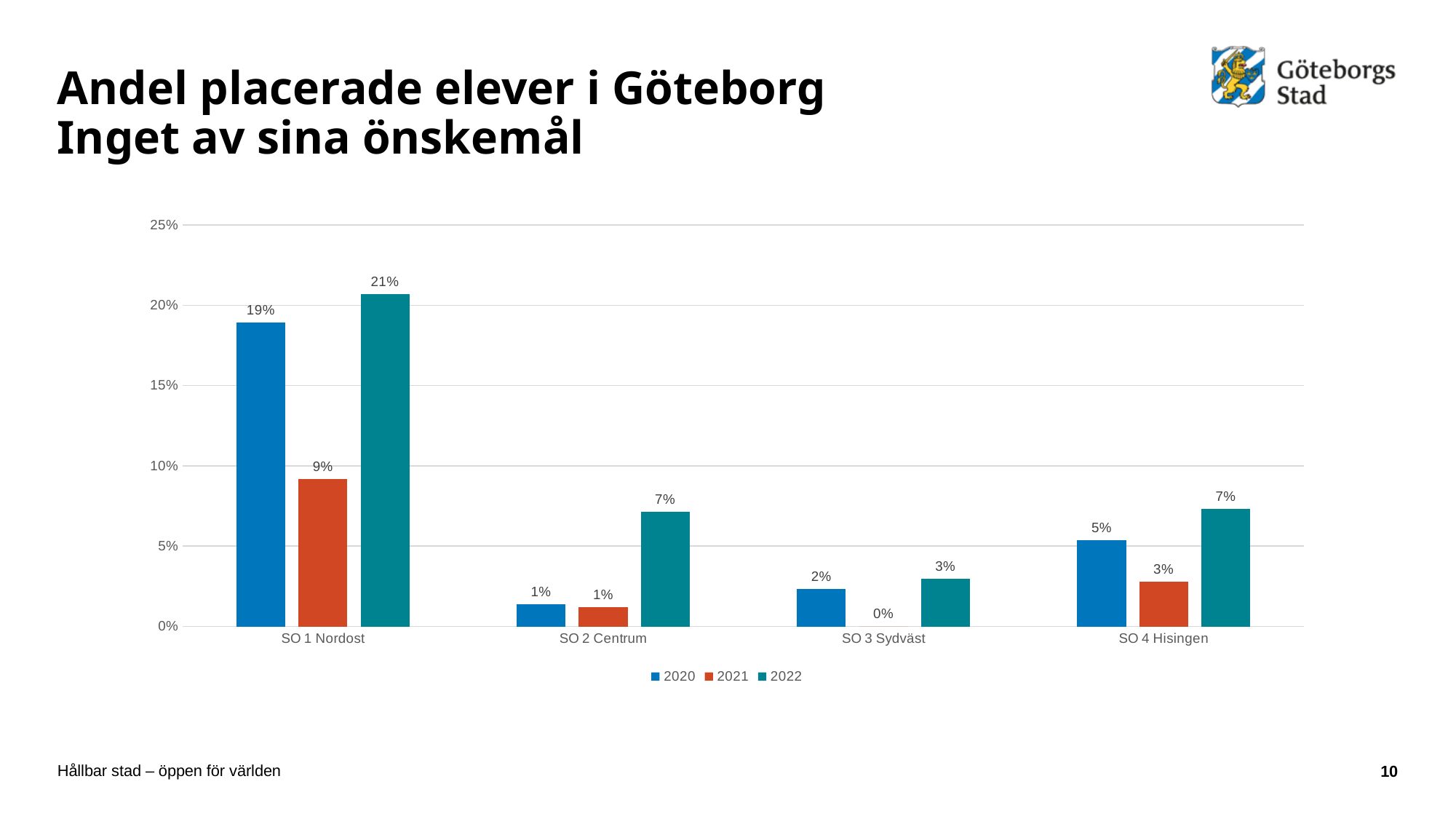
What are the entries in the chart legend? 2020, 2021, 2022 What is the value for 2022 in SO 1 Nordost? 21% Which category has the highest value for the 2022 series? SO 1 Nordost Is the 2022 value for SO 1 Nordost greater or less than 20%? greater How many categories are shown on the x axis? 4 What is the difference between the 2020 and 2021 values for SO 1 Nordost? 10% What kind of chart is shown on the slide? Bar chart Which category has the lowest value for the 2021 series? SO 3 Sydväst What is the value for 2021 in SO 3 Sydväst? 0% What is the value for 2020 in SO 4 Hisingen? 5% How many series does the legend list? 3 Which is larger: the 2022 value for SO 2 Centrum or the 2020 value for SO 4 Hisingen? The 2022 value for SO 2 Centrum